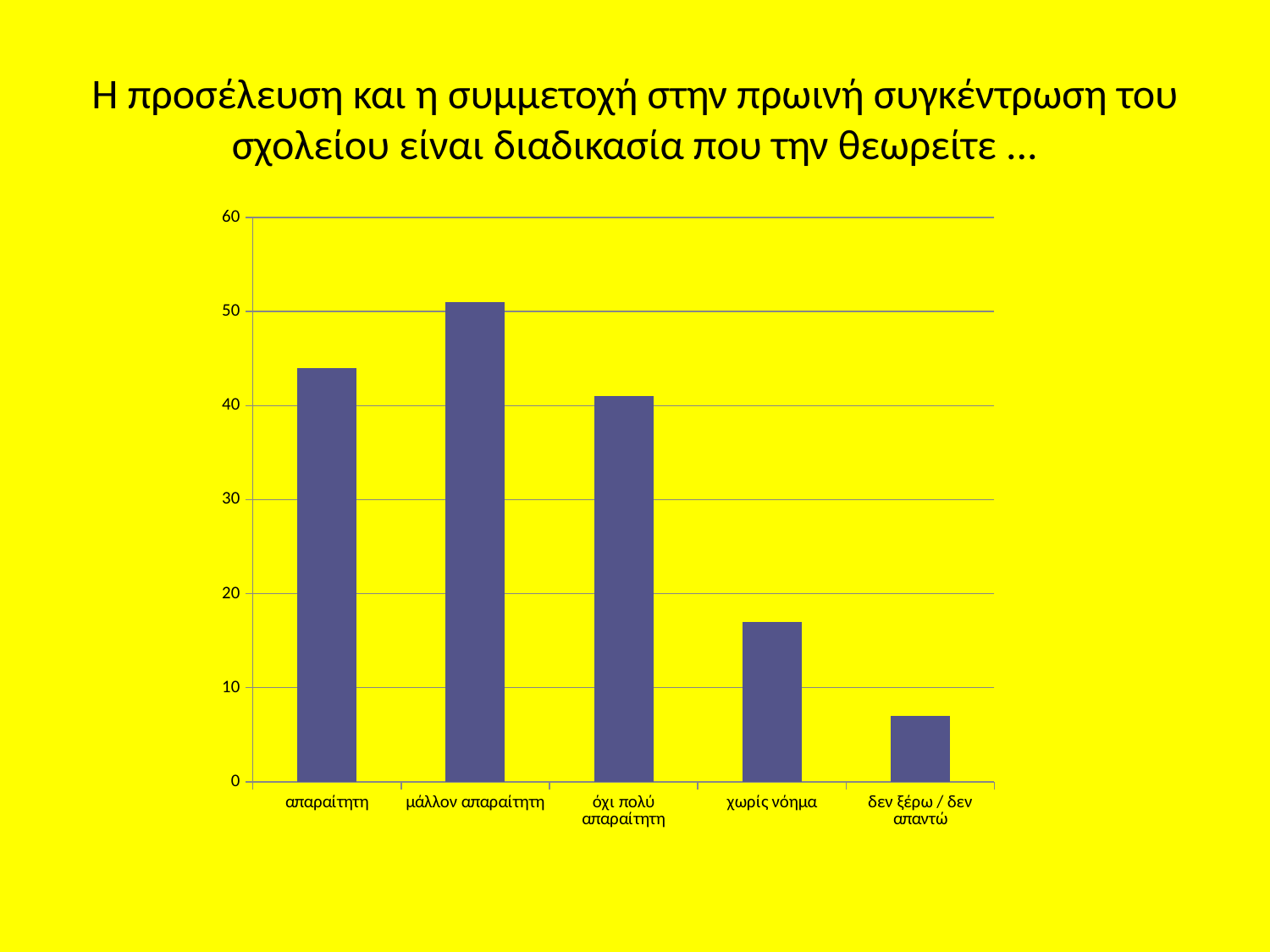
Is the value for δεν ξέρω / δεν απαντώ greater or less than 10? less Which category has the highest bar? μάλλον απαραίτητη What is the maximum value shown on the y axis of the chart? 60 Which is larger, the value for χωρίς νόημα or the value for δεν ξέρω / δεν απαντώ? χωρίς νόημα Which is larger, the value for μάλλον απαραίτητη or the value for απαραίτητη? μάλλον απαραίτητη How many categories are shown on the x axis of the chart? 5 Is the value for όχι πολύ απαραίτητη greater or less than 50? less What kind of chart is shown on the slide? bar chart Which category has the lowest bar? δεν ξέρω / δεν απαντώ Is the value for μάλλον απαραίτητη greater or less than 60? less